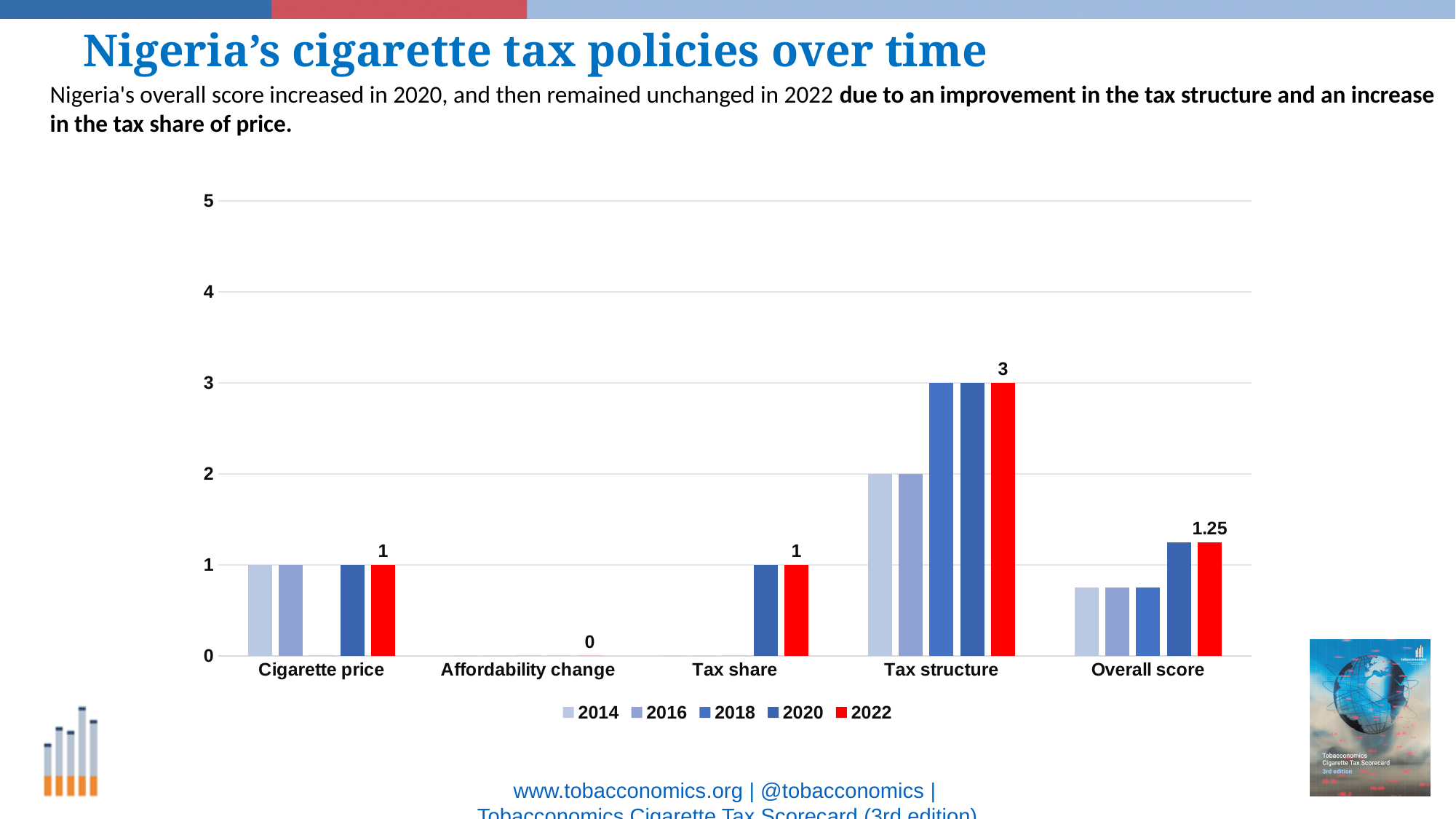
What kind of chart is shown on the slide? bar chart Is the value for Overall score in 2014 greater or less than 1? less How many series does the legend list? 5 How many categories are shown on the x axis? 5 What is the difference between the 2022 values for Tax structure and Overall score? 1.75 What is the value for Overall score in 2022? 1.25 What is the value for Tax structure in 2014? 2 Which category has the highest value for 2022? Tax structure Which is larger in 2022: Tax share or Overall score? Overall score What is the value for Tax structure in 2022? 3 What is the value for Affordability change in 2022? 0 Which category has the lowest value for 2022? Affordability change